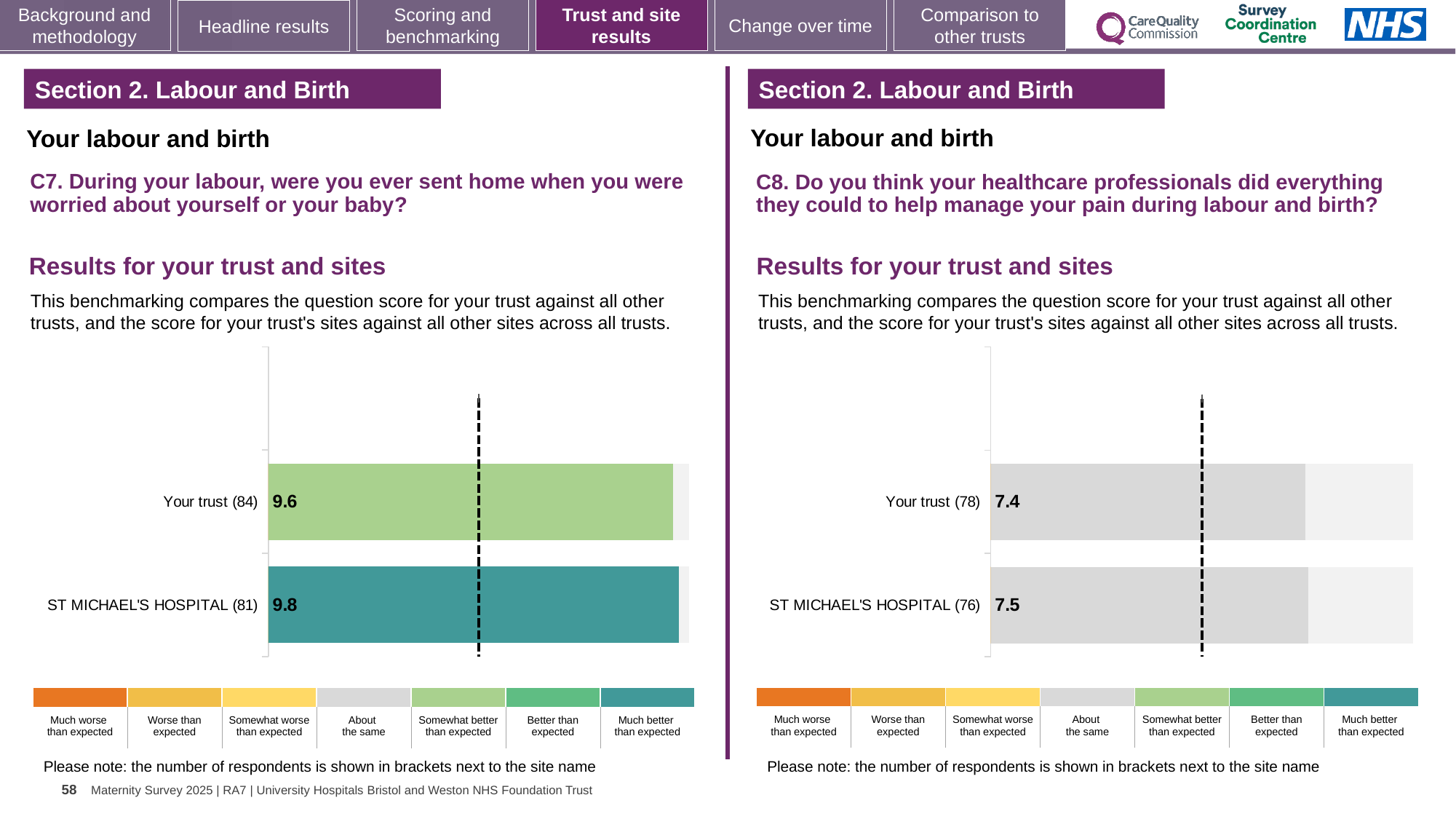
In the C8 chart on the right, what is the score for ST MICHAEL'S HOSPITAL? 7.5 In the C7 chart on the left, what is the score for Your trust? 9.6 In the C7 chart on the left, what is the score for ST MICHAEL'S HOSPITAL? 9.8 In the C8 chart on the right, how many respondents are shown in brackets for Your trust? 78 According to the colour key, which benchmark category does the ST MICHAEL'S HOSPITAL bar in the C7 chart on the left fall into? Much better than expected In the C7 chart on the left, what is the difference between the ST MICHAEL'S HOSPITAL score and the Your trust score? 0.2 In the C7 chart on the left, how many respondents are shown in brackets for ST MICHAEL'S HOSPITAL? 81 How many bars are plotted in the C8 chart on the right? 2 In the C8 chart on the right, what is the difference between the ST MICHAEL'S HOSPITAL score and the Your trust score? 0.1 In the C8 chart on the right, what is the score for Your trust? 7.4 In the C7 chart on the left, which has the higher score, Your trust or ST MICHAEL'S HOSPITAL? ST MICHAEL'S HOSPITAL What type of chart is used in the C7 chart on the left? Bar chart